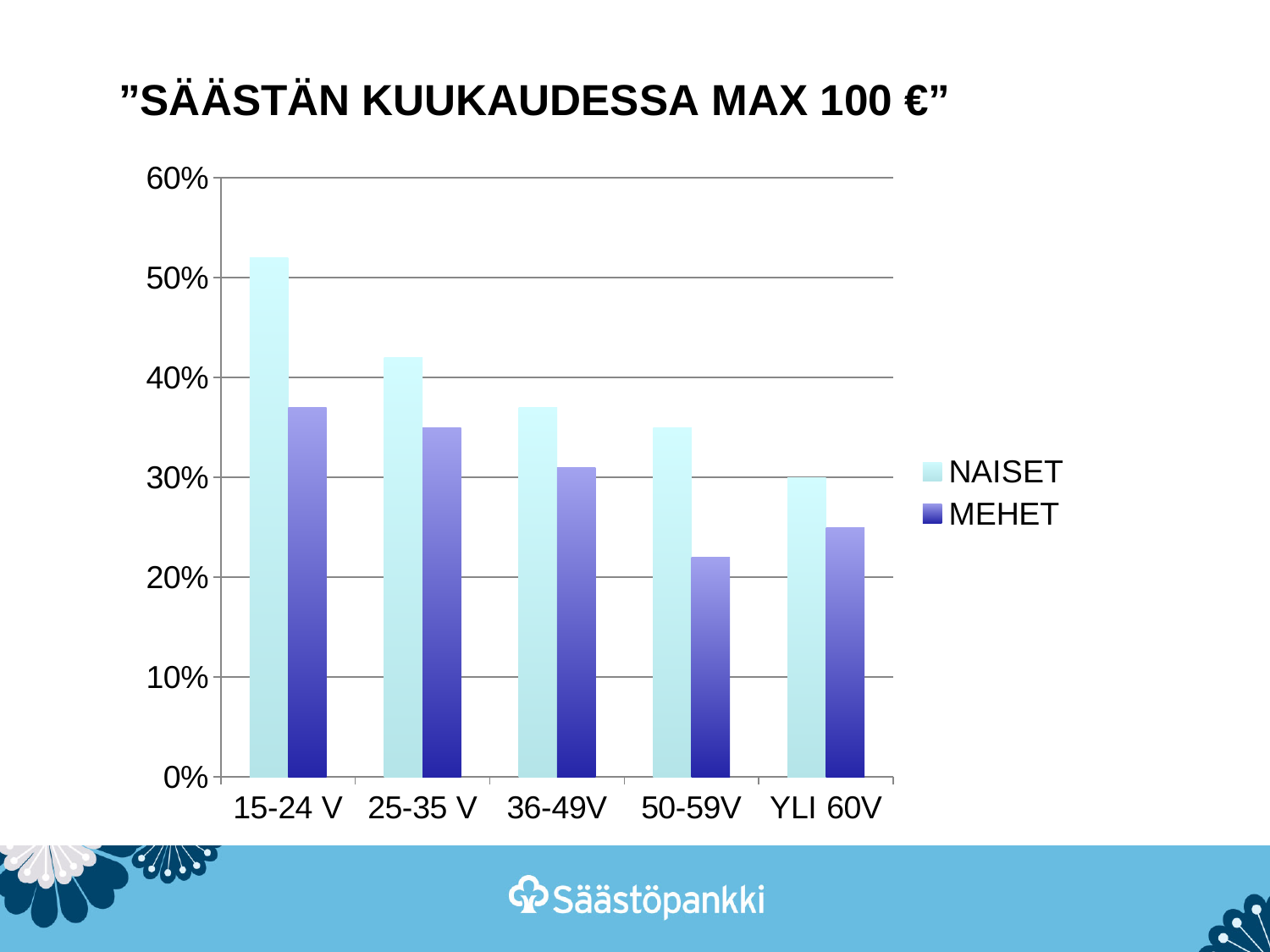
How many series does the legend list? 2 Which age group has the lowest value for NAISET? YLI 60V Which age group has the highest value for NAISET? 15-24 V What is the title of the chart? "SÄÄSTÄN KUUKAUDESSA MAX 100 €" In the 15-24 V group, which series has the larger value, NAISET or MEHET? NAISET Do the NAISET values rise or fall as the age groups move from 15-24 V to YLI 60V? fall How many age groups are shown on the x axis? 5 Which age group has the lowest value for MEHET? 50-59V Is the value for MEHET in the 50-59V group greater or less than 30%? less Is the value for NAISET in the 36-49V group greater or less than 40%? less Is the value for NAISET in the 15-24 V group greater or less than 50%? greater What kind of chart is shown on the slide? bar chart